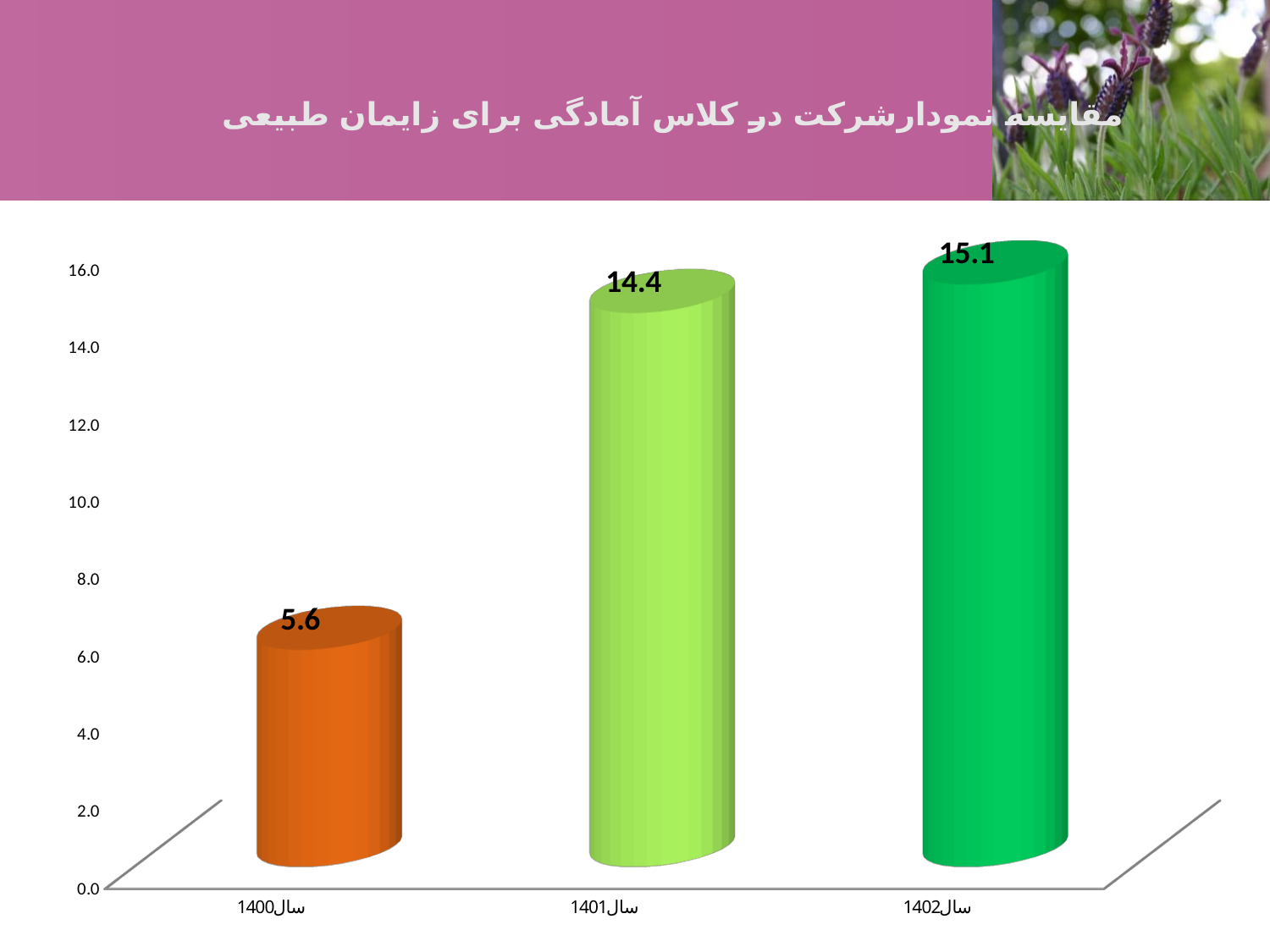
What is the difference between the values for سال1402 and سال1401? 0.7 How many categories are shown on the x axis? 3 What is the value for سال1401? 14.4 Is the value for سال1400 greater or less than 6.0? less Do the values rise or fall from سال1400 to سال1402? rise Which year has the highest value? سال1402 What is the difference between the values for سال1401 and سال1400? 8.8 Which is larger, the value for سال1400 or the value for سال1401? سال1401 What is the value for سال1402? 15.1 What kind of chart is shown on the slide? bar chart Which year has the lowest value? سال1400 What is the value for سال1400? 5.6